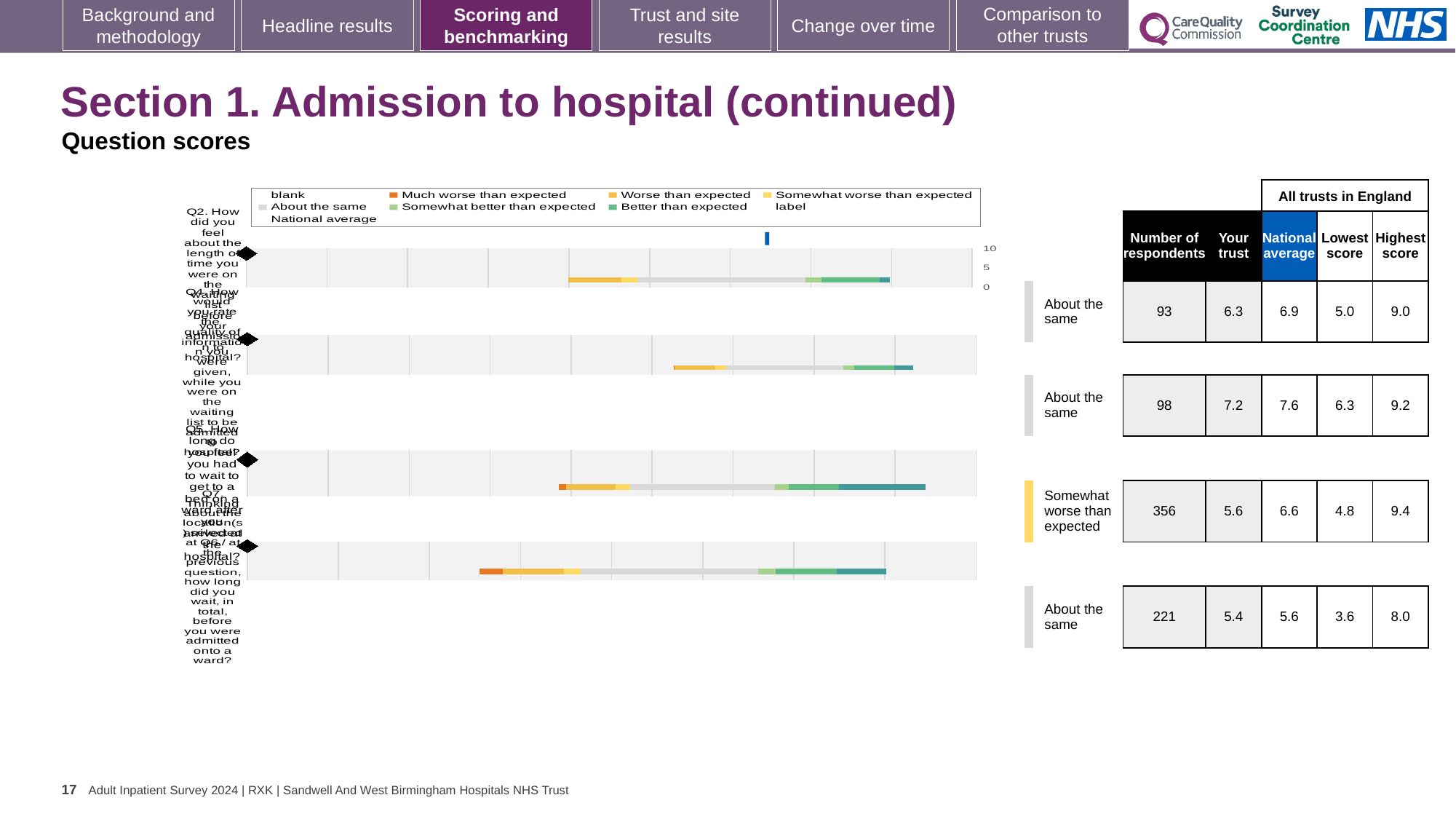
Which row of the table has the lowest 'Your trust' score? the fourth row (5.4) What is the heading above the 'National average', 'Lowest score' and 'Highest score' columns? All trusts in England Is the 'Your trust' score for the second row (98 respondents) higher or lower than its national average? lower What is the highest score in England for the third row of the table (356 respondents)? 9.4 How many question rows (bars) are plotted in the chart? 4 Which row of the table has the largest number of respondents? the third row (356 respondents) What is the 'Your trust' score for the first row of the table (93 respondents)? 6.3 What benchmark category is shown for the third row (356 respondents)? Somewhat worse than expected What is the difference between the national average and the 'Your trust' score for the third row (356 respondents)? 1.0 What is the national average for the second row of the table (98 respondents)? 7.6 What kind of chart is shown on the slide? bar chart What is the lowest score in England for the fourth row of the table (221 respondents)? 3.6